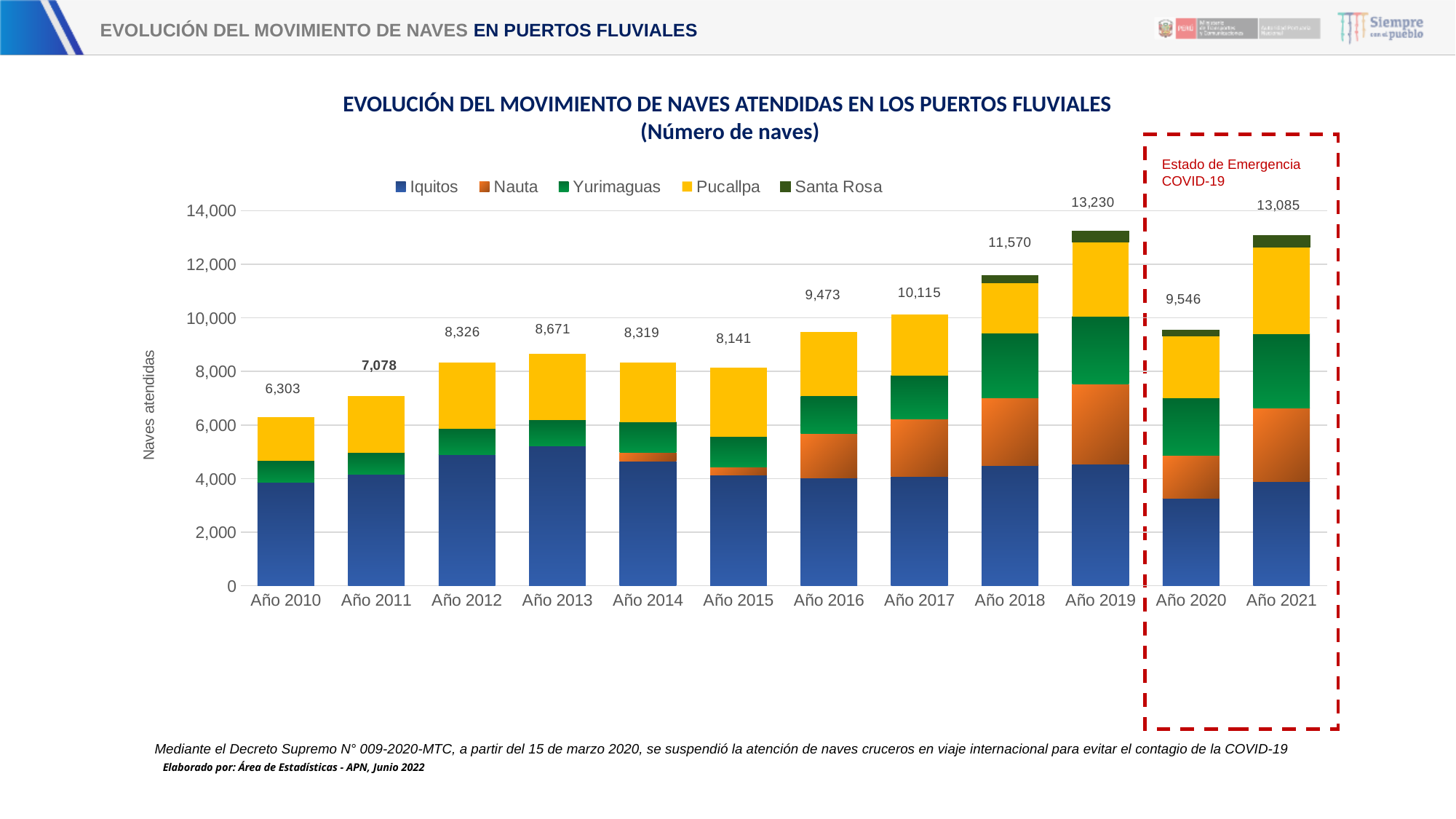
Which year has the highest total of naves atendidas? Año 2019 What is the total number of naves atendidas shown for Año 2019? 13,230 Which year has the lowest total of naves atendidas? Año 2010 What is the difference between the totals for Año 2019 and Año 2020? 3,684 What kind of chart is shown on the slide? Stacked bar chart What is the total number of naves atendidas shown for Año 2010? 6,303 Do the totals rise or fall from Año 2010 to Año 2013? Rise Which total is larger, Año 2013 or Año 2015? Año 2013 How many years are shown on the x axis? 12 What is the total number of naves atendidas shown for Año 2020? 9,546 Is the value for Iquitos in Año 2020 greater or less than 4,000? less How many series does the legend list? 5